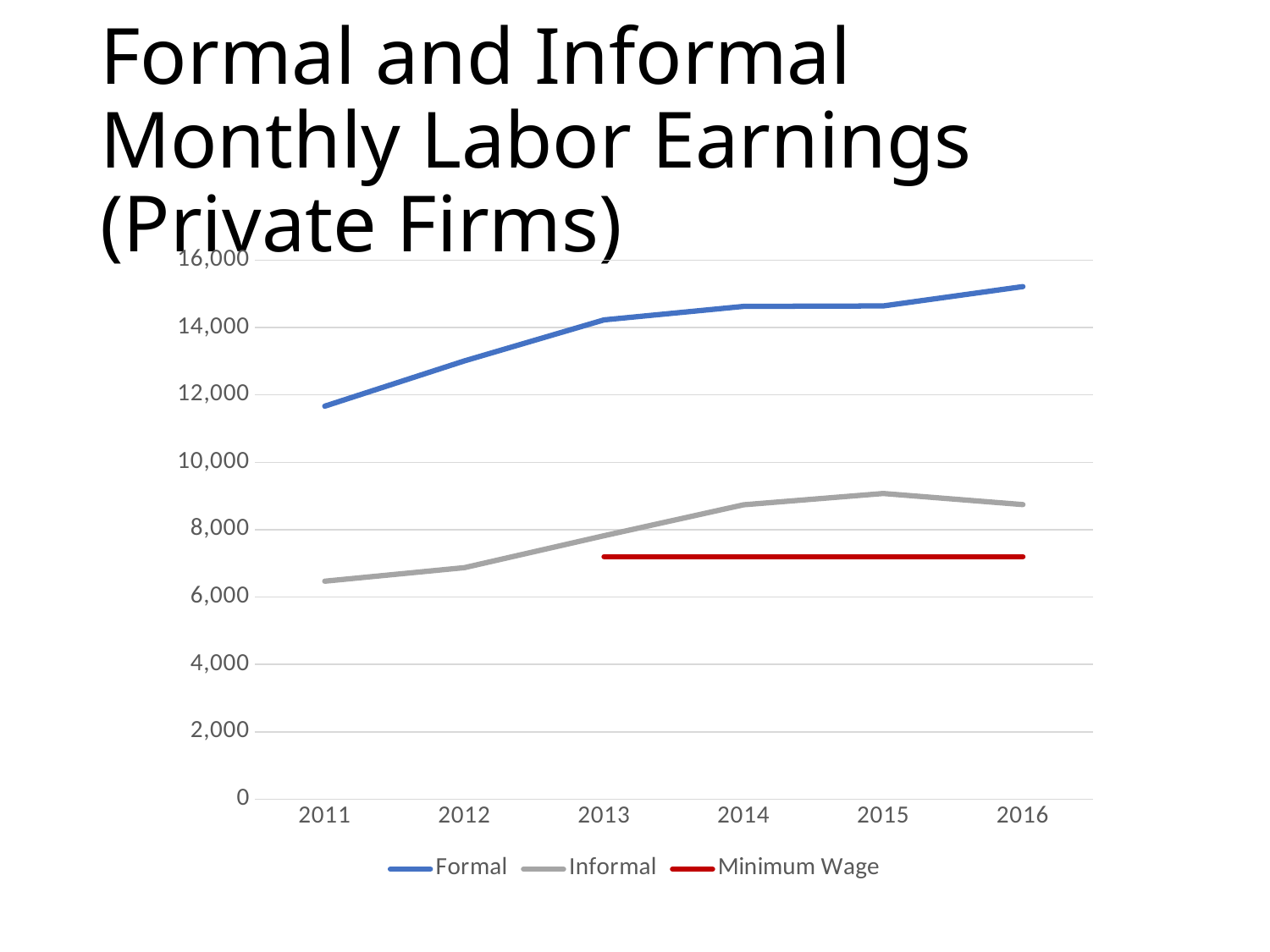
What kind of chart is shown on the slide? line chart In which year is the Formal series highest? 2016 How many years are shown on the x axis? 6 In which year is the Informal series highest? 2015 In which year is the Formal series lowest? 2011 Is the Formal value for 2011 greater or less than 12,000? less Do the Formal earnings rise or fall from 2011 to 2016? rise How many series does the legend list? 3 Is the Formal value for 2016 greater or less than 14,000? greater Which series is higher in 2014, Formal or Informal? Formal What colour is the Minimum Wage line? red Is the Informal value for 2015 greater or less than 8,000? greater